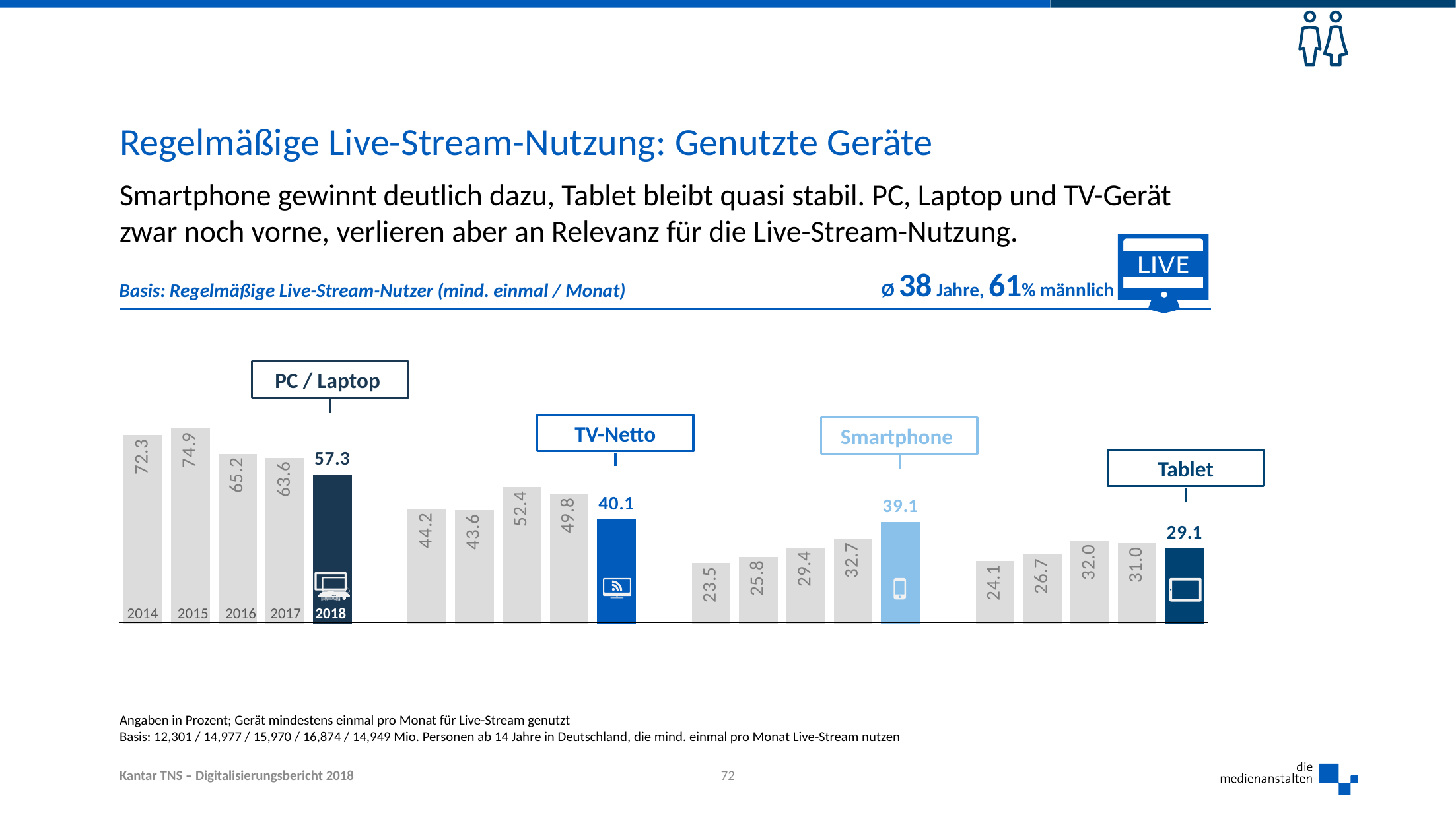
Which is larger in 2018, the value for TV-Netto or the value for Smartphone? TV-Netto How many bars are shown for each device group? 5 What is the value shown for the highlighted 2018 bar of Tablet? 29.1 What is the value shown for the highlighted 2018 bar of TV-Netto? 40.1 What is the value for PC / Laptop in 2014? 72.3 In which year did PC / Laptop reach its highest value? 2015 Which device group has the lowest 2018 value? Tablet What kind of chart is shown on the slide? Bar chart Do the Smartphone values rise or fall from the first bar to the last bar? Rise What is the difference between the PC / Laptop values for 2015 and 2018? 17.6 What is the value for PC / Laptop in 2018? 57.3 What is the value shown for the highlighted 2018 bar of Smartphone? 39.1